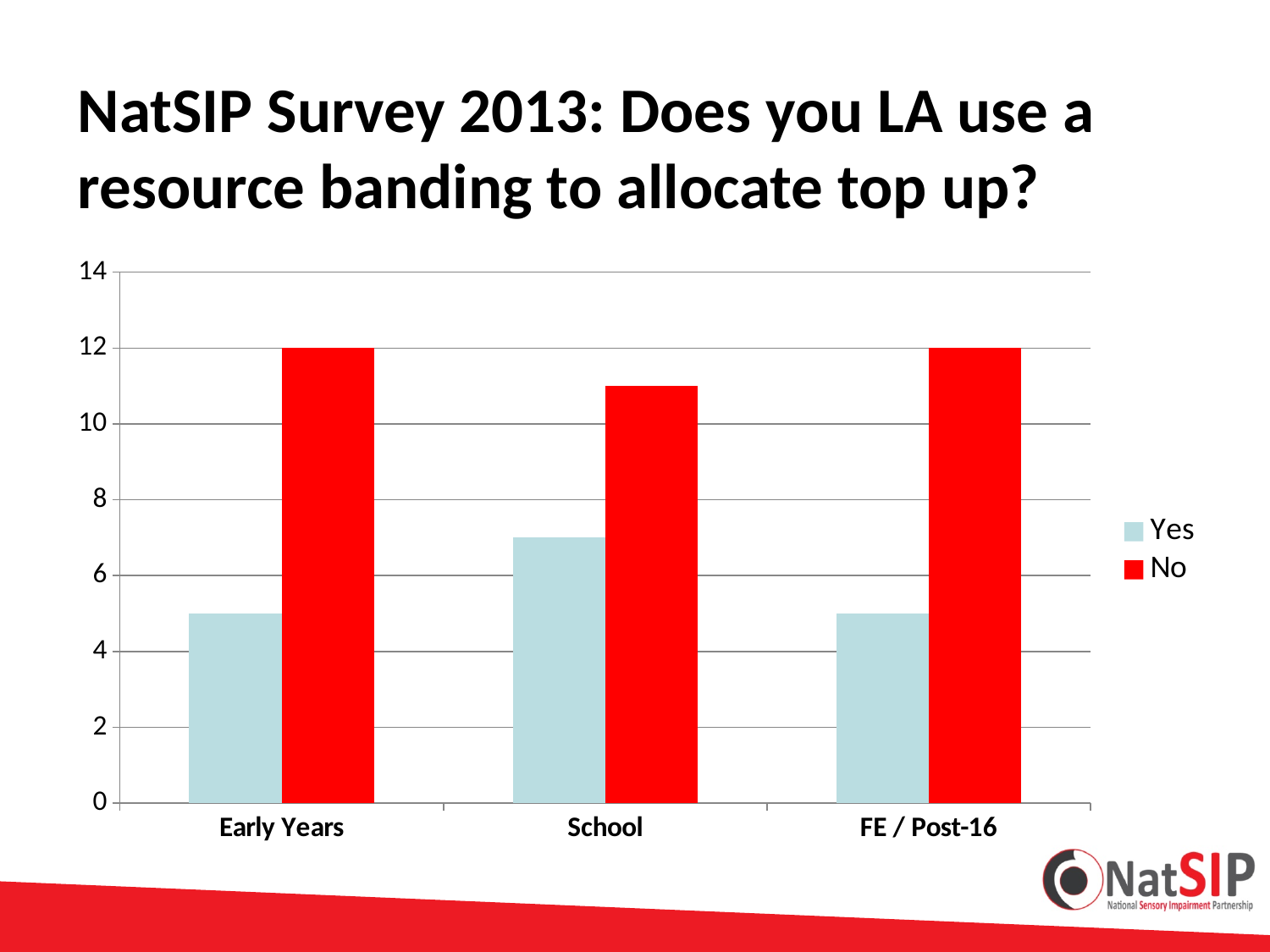
Which category has the lowest No value? School Which category has the highest Yes value? School Is the Yes value for School greater or less than 6? greater How many categories are shown on the x axis? 3 Which series is shown in red? No Is the Yes value for Early Years greater or less than 6? less For School, which is larger, the Yes value or the No value? No What is the value of the No bar for Early Years? 12 Is the No value for School greater or less than 10? greater How many series does the legend list? 2 What is the value of the No bar for FE / Post-16? 12 What kind of chart is shown on the slide? bar chart